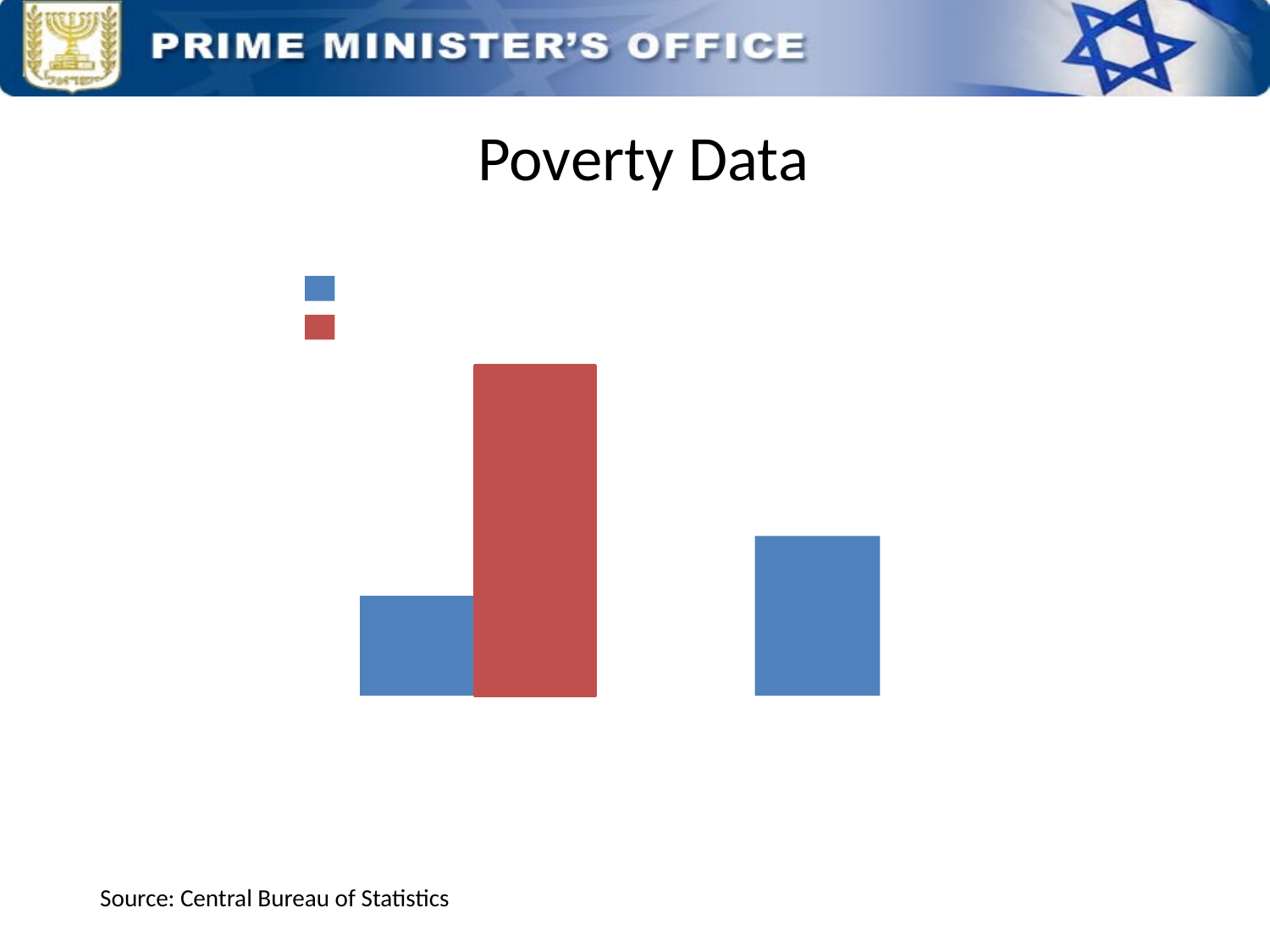
How many series does the chart's legend list? 2 How many bars are plotted in the chart? 3 What kind of chart is shown on the slide? bar chart Is the rightmost blue bar taller or shorter than the leftmost blue bar? taller Is the red bar taller or shorter than the blue bar to its left? taller What two colours are used for the bars in the chart? blue and red Which colour is the shortest bar in the chart? blue Which colour is the tallest bar in the chart? red What is the title shown above the chart? Poverty Data